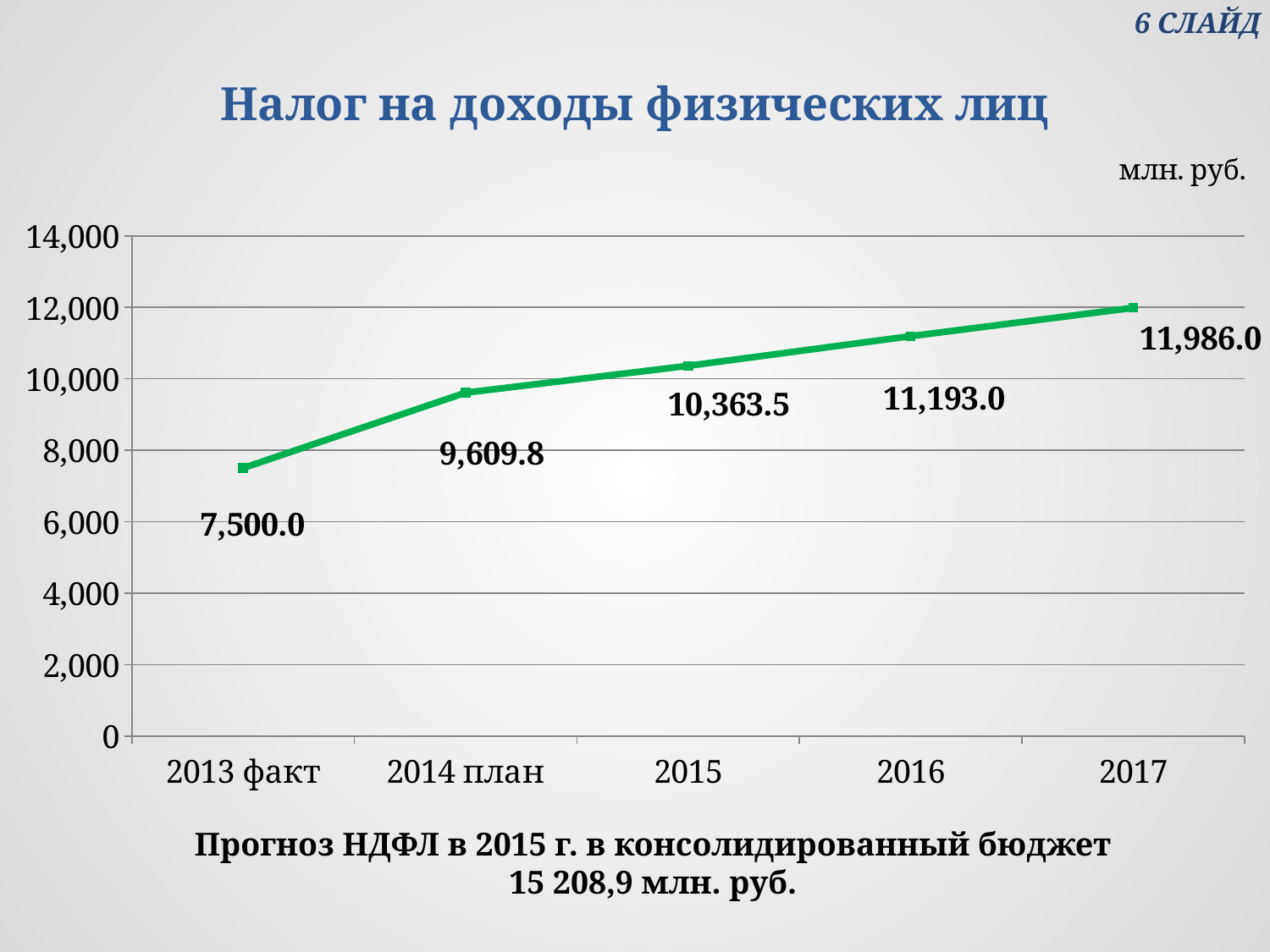
How many data points are plotted on the chart? 5 What is the difference between the values for 2016 and 2015? 829.5 What is the value for 2015? 10,363.5 What is the value for 2014 план? 9,609.8 Which category has the lowest value? 2013 факт What kind of chart is shown on the slide? Line chart What is the value for 2013 факт? 7,500.0 What is the value for 2017? 11,986.0 Do the values rise or fall from 2013 факт to 2017? Rise Which year has the highest value? 2017 What is the difference between the values for 2017 and 2013 факт? 4,486.0 Which is larger, the value for 2016 or the value for 2014 план? 2016